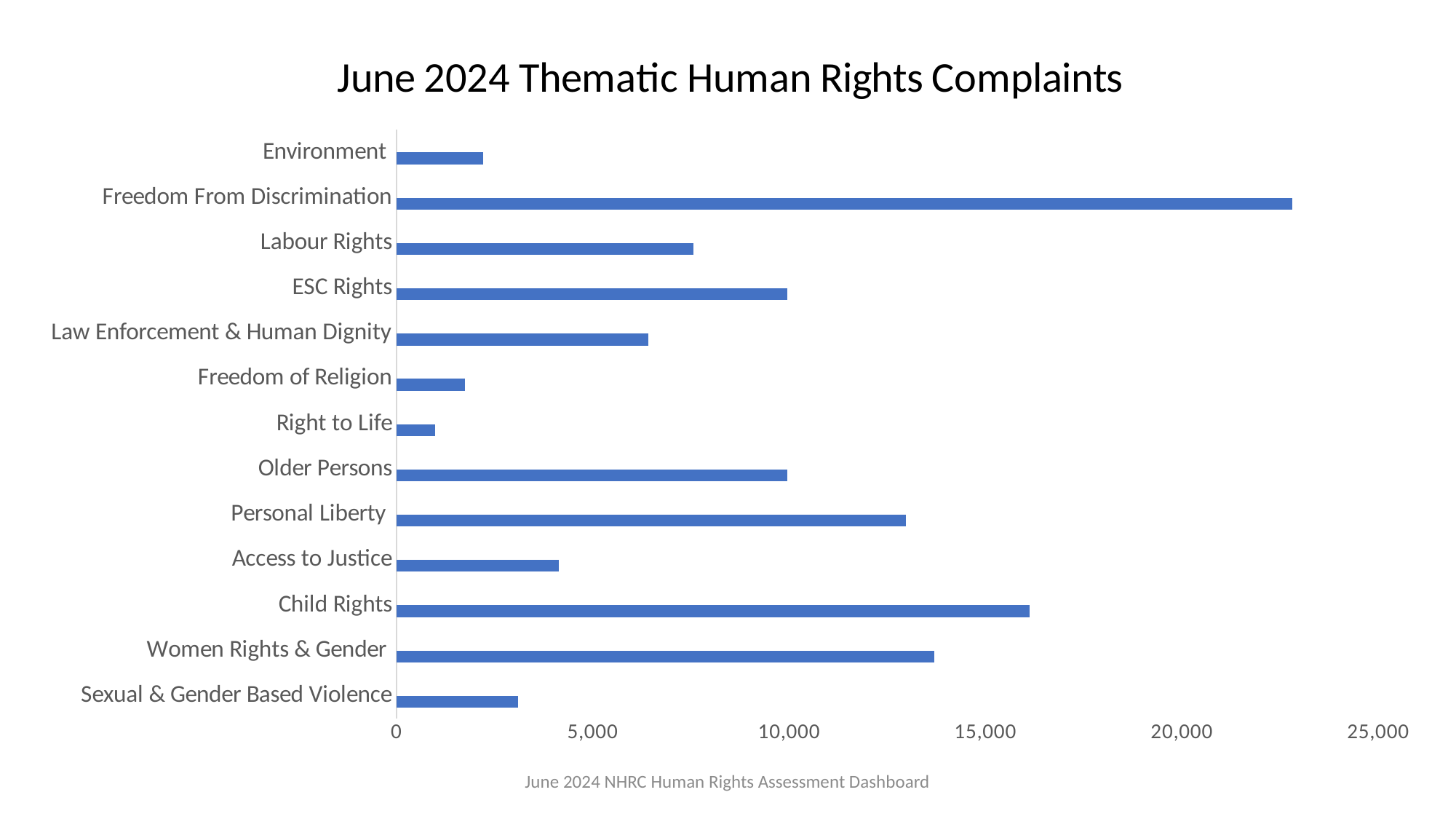
Which category has the lowest number of complaints? Right to Life Is the value for Personal Liberty greater or less than 10,000? greater Is the value for Child Rights greater or less than 15,000? greater What type of chart is shown on the slide? Bar chart Which category has the highest number of complaints? Freedom From Discrimination How many categories are plotted in the chart? 13 Is the value for Labour Rights greater or less than 5,000? greater Which has more complaints, Child Rights or Women Rights & Gender? Child Rights What source is cited below the chart? June 2024 NHRC Human Rights Assessment Dashboard What is the title of the chart? June 2024 Thematic Human Rights Complaints